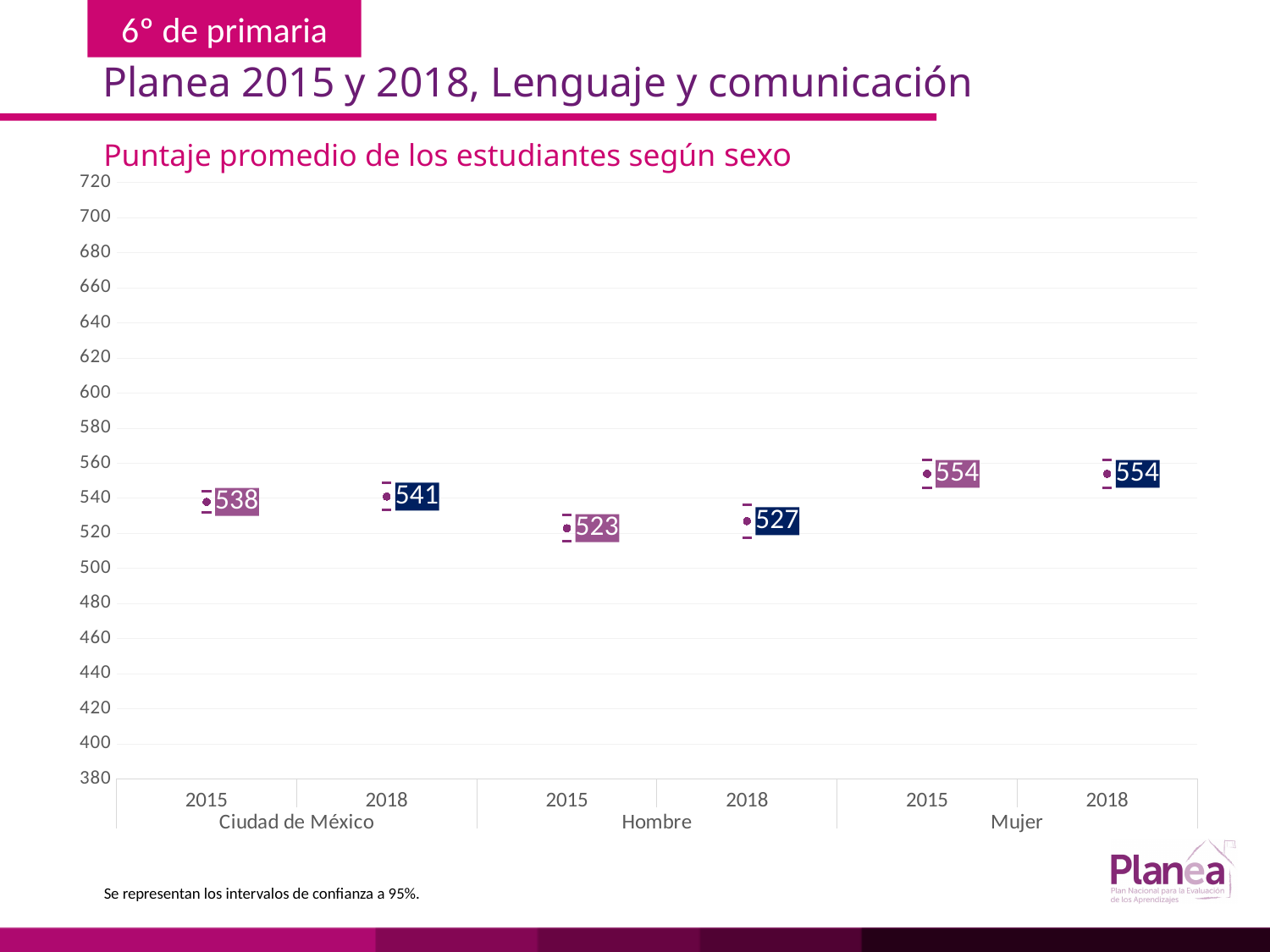
What is the title of the chart? Puntaje promedio de los estudiantes según sexo By how much did the Ciudad de México average score change from 2015 to 2018? 3 Which group and year has the lowest average score? Hombre 2015 What is the difference between the Mujer and Hombre average scores in 2018? 27 What is the average score for Ciudad de México in 2018? 541 Is the Mujer score in 2018 greater or less than 540? greater Did the Mujer average score rise, fall or stay the same from 2015 to 2018? stayed the same Which is larger, the Hombre score in 2015 or the Hombre score in 2018? Hombre 2018 How many data points are plotted on the chart? 6 What is the average score for Mujer in 2015? 554 What is the average score for Hombre in 2018? 527 What is the average score for Ciudad de México in 2015? 538